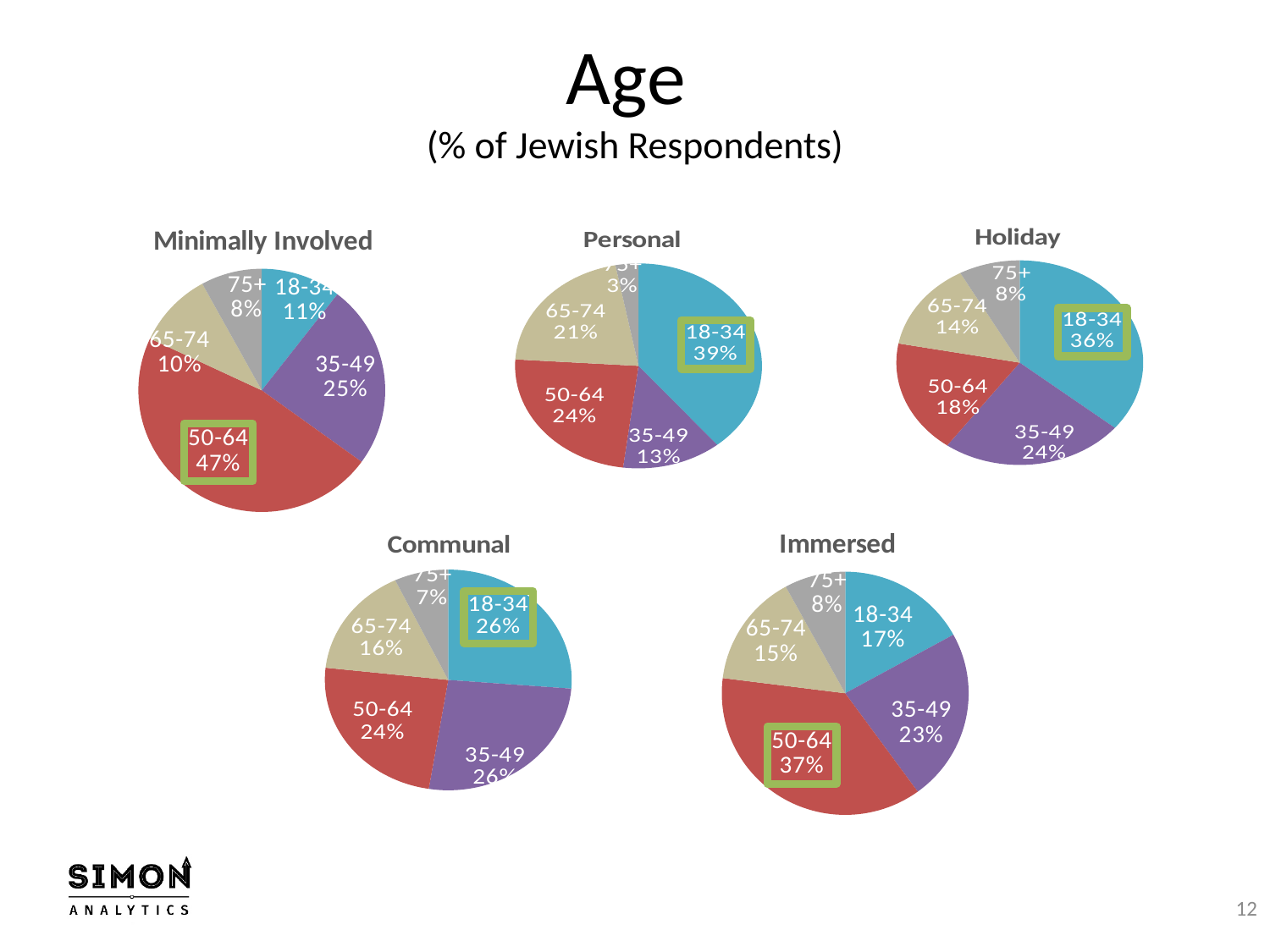
In the Minimally Involved pie chart, which is larger: the 35-49 share or the 18-34 share? 35-49 In the Holiday pie chart, what is the value for the 65-74 age group? 14% In the Immersed pie chart, which age group has the largest share? 50-64 In the Personal pie chart, which age group has the smallest share? 75+ In the Minimally Involved pie chart, what share of respondents are aged 50-64? 47% What type of chart is used for the Holiday data? Pie chart How many age groups are shown in the Communal pie chart? 5 In the Communal pie chart, which age group has the smallest share? 75+ In the Holiday pie chart, how much larger is the 18-34 share than the 50-64 share? 18% How many pie charts are shown on the slide? 5 In the Personal pie chart, what percentage of respondents are aged 18-34? 39% In the Immersed pie chart, what percentage of respondents are aged 35-49? 23%